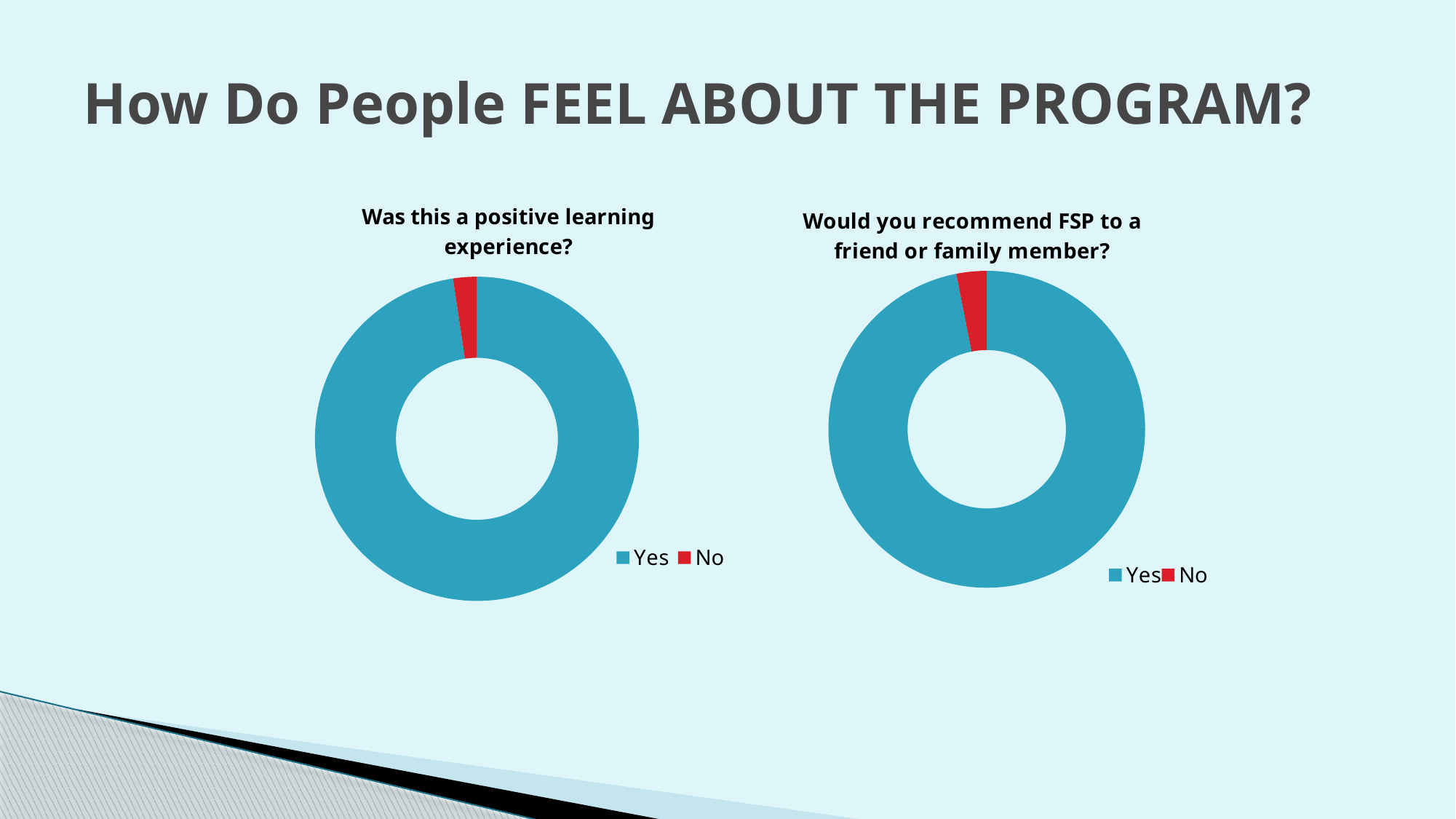
In the chart titled "Was this a positive learning experience?", which is larger, Yes or No? Yes What is the title of the chart on the right of the slide? Would you recommend FSP to a friend or family member? In the chart titled "Would you recommend FSP to a friend or family member?", which is larger, Yes or No? Yes In the chart titled "Would you recommend FSP to a friend or family member?", which category has the smallest share? No In the chart titled "Was this a positive learning experience?", which category has the largest share? Yes In the chart titled "Would you recommend FSP to a friend or family member?", which category has the largest share? Yes In the chart titled "Was this a positive learning experience?", which category has the smallest share? No How many entries does the legend of the chart titled "Would you recommend FSP to a friend or family member?" list? 2 How many categories does the chart titled "Was this a positive learning experience?" show? 2 What kind of chart is the chart titled "Was this a positive learning experience?"? doughnut chart In the chart on the left, what colour represents the No category? red What kind of chart is the chart titled "Would you recommend FSP to a friend or family member?"? doughnut chart